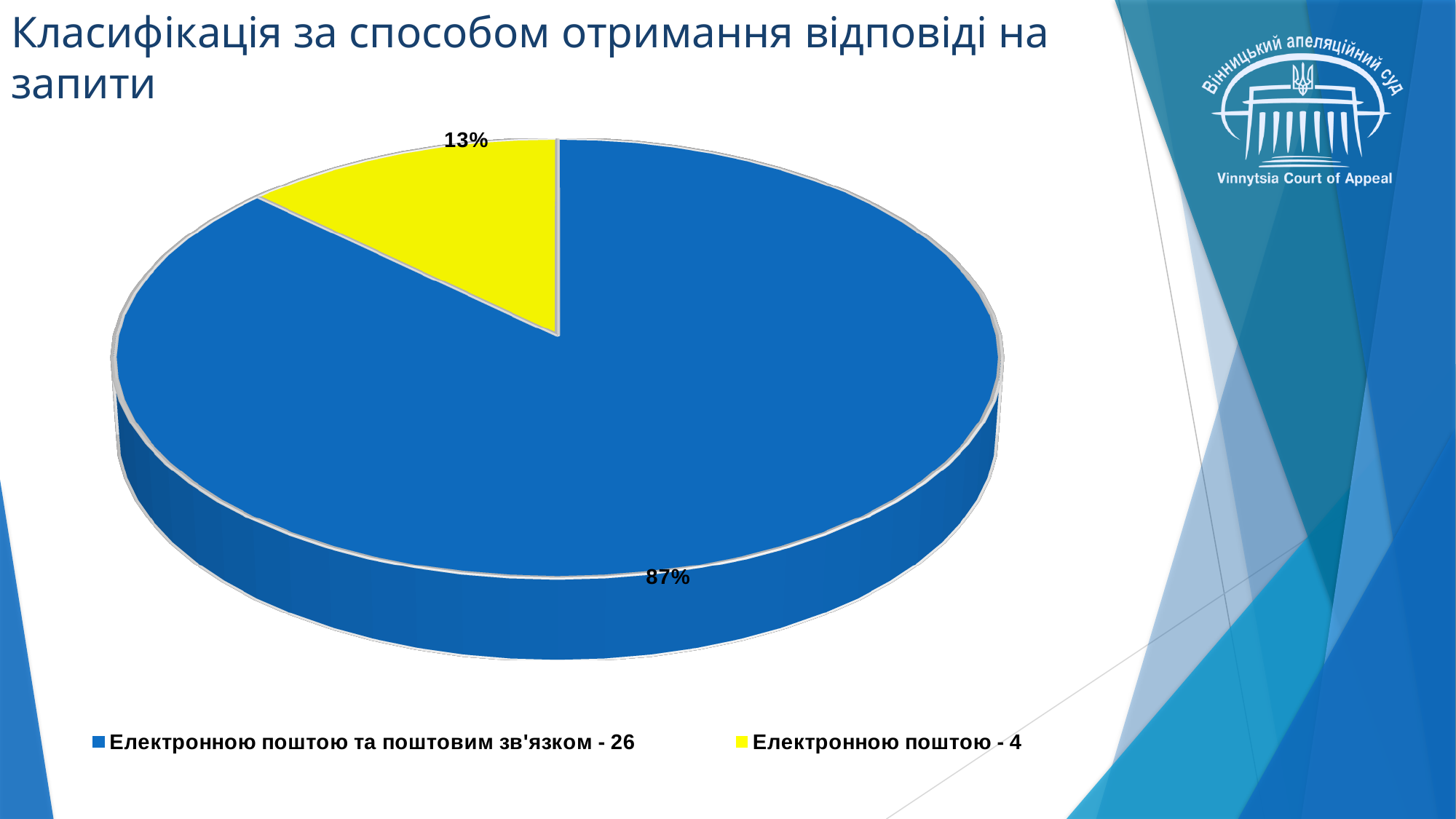
Which category has the smallest slice of the pie? Електронною поштою Which category has the largest slice of the pie? Електронною поштою та поштовим зв'язком How many slices does the pie chart have? 2 What kind of chart is shown on the slide? Pie chart What count is shown in the legend for "Електронною поштою та поштовим зв'язком"? 26 Which is larger: the share for "Електронною поштою" or the share for "Електронною поштою та поштовим зв'язком"? Електронною поштою та поштовим зв'язком What percentage share does the slice "Електронною поштою та поштовим зв'язком" have? 87% What colour is the slice for "Електронною поштою"? Yellow How many entries does the legend list? 2 What is the difference in percentage points between the 87% slice and the 13% slice? 74 What percentage share does the slice "Електронною поштою" have? 13% What count is shown in the legend for "Електронною поштою"? 4